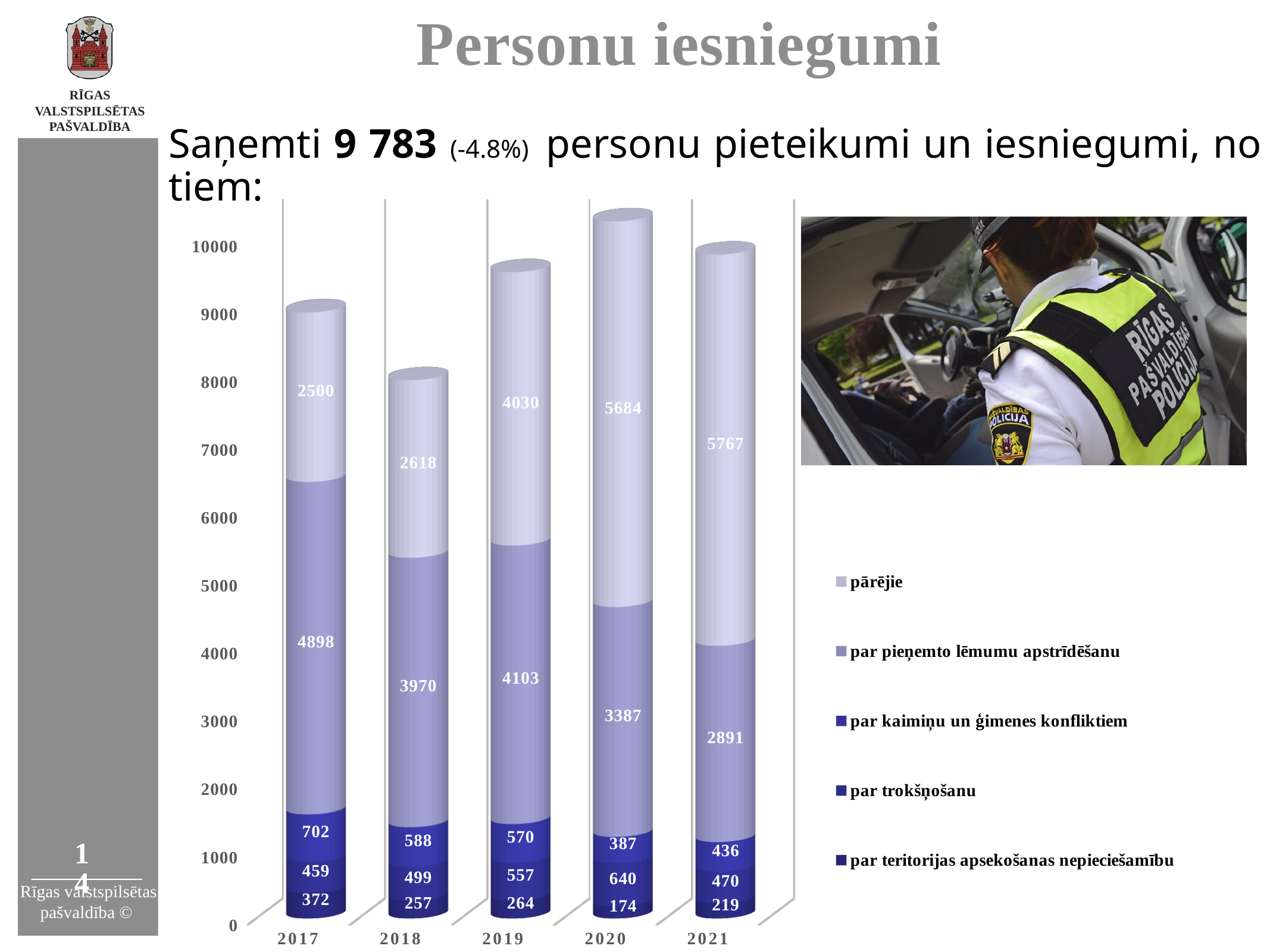
What is the value for pārējie in 2021? 5767 Which year has the larger value for par kaimiņu un ģimenes konfliktiem, 2018 or 2019? 2018 What is the difference between the par pieņemto lēmumu apstrīdēšanu values for 2017 and 2021? 2007 What is the total of the stacked bar for 2021? 9783 Does the pārējie segment rise or fall from 2017 to 2021? Rises What kind of chart is shown on the slide? Stacked bar chart How many years are shown on the x axis? 5 How many series does the legend list? 5 In which year is the pārējie segment the highest? 2021 In which year is the par teritorijas apsekošanas nepieciešamību segment the lowest? 2020 What is the value for par teritorijas apsekošanas nepieciešamību in 2017? 372 What is the value for par trokšņošanu in 2020? 640